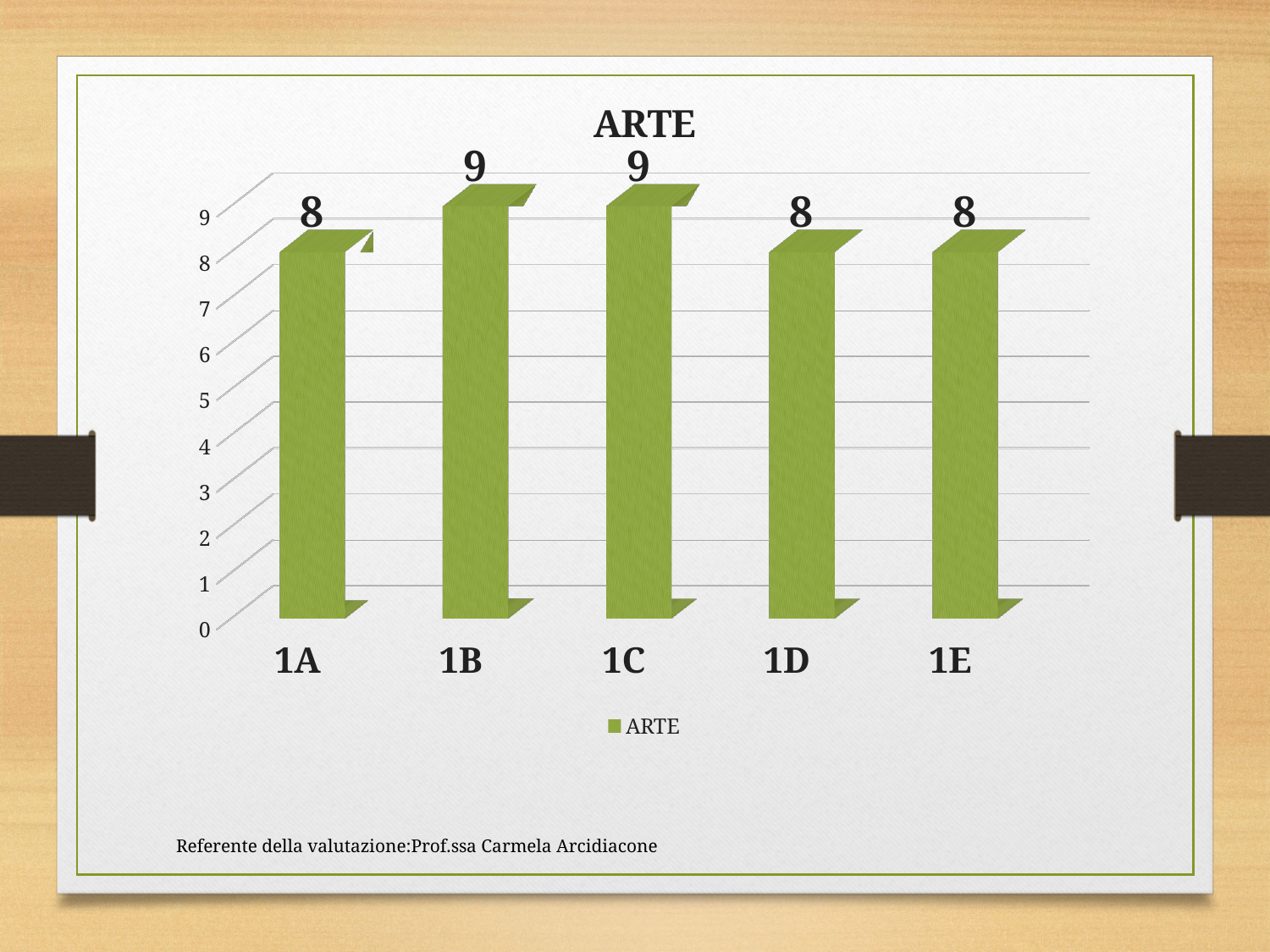
What is the difference between the values for 1B and 1A? 1 What is the value for 1E in the ARTE chart? 8 How many series does the legend list? 1 What is the value for 1D in the ARTE chart? 8 What kind of chart is shown on the slide? bar chart What is the value for 1A in the ARTE chart? 8 What is the value for 1B in the ARTE chart? 9 Which is larger, the value for 1C or the value for 1D? 1C How many categories are shown on the x axis of the chart? 5 Is the value for 1E greater or less than 5? greater What is the title of the chart? ARTE Which categories have the highest value in the ARTE chart? 1B and 1C